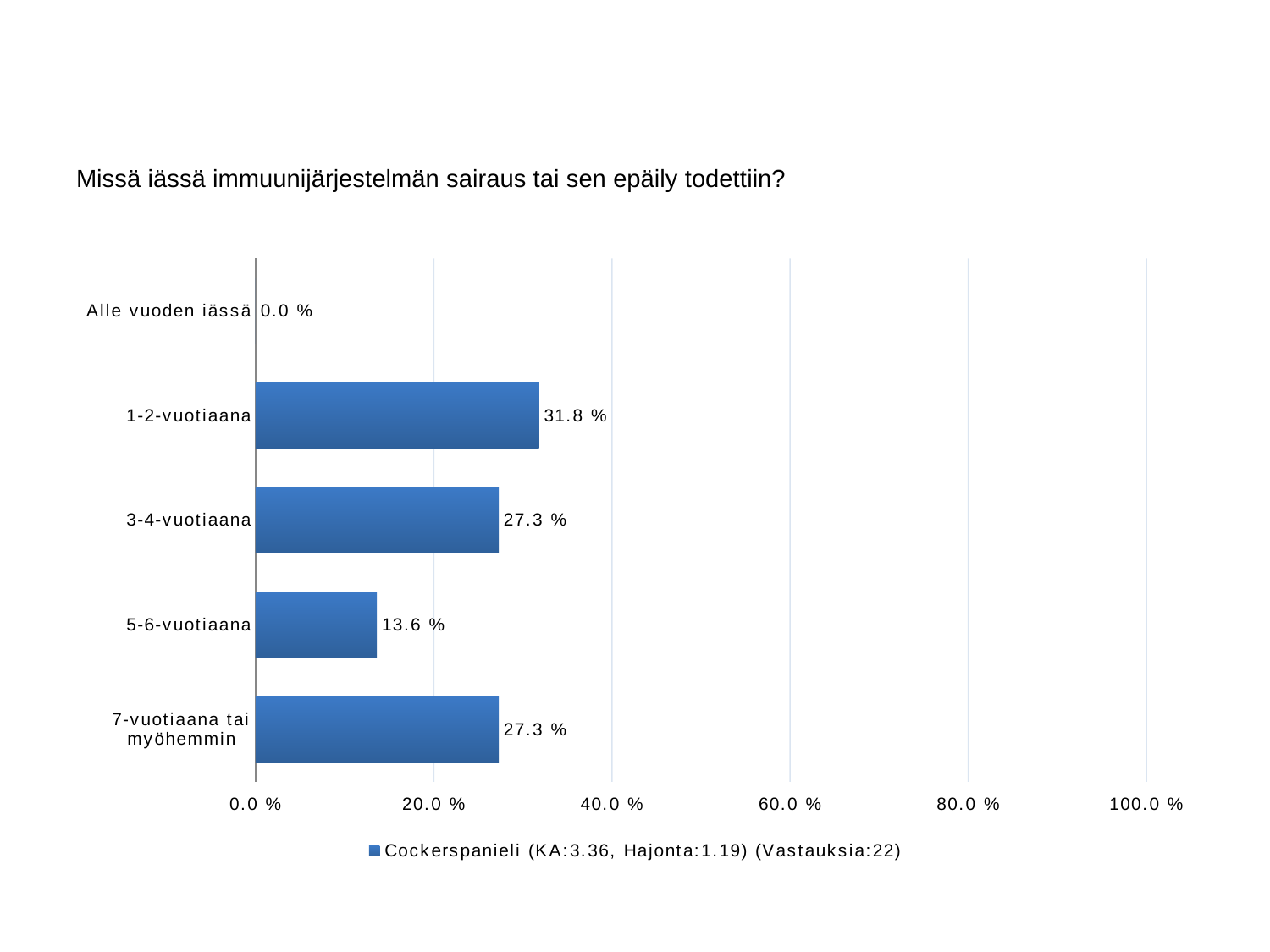
How many categories are shown on the chart? 5 Which category has the highest value? 1-2-vuotiaana What is the legend entry of the chart? Cockerspanieli (KA:3.36, Hajonta:1.19) (Vastauksia:22) What is the value for 1-2-vuotiaana? 31.8 % What is the difference between the values for 1-2-vuotiaana and 5-6-vuotiaana? 18.2 % Which is larger, the value for 3-4-vuotiaana or the value for 5-6-vuotiaana? 3-4-vuotiaana What is the value for 7-vuotiaana tai myöhemmin? 27.3 % Which category has the lowest value? Alle vuoden iässä What is the value for 5-6-vuotiaana? 13.6 % Is the value for 1-2-vuotiaana greater or less than 40.0 %? less What kind of chart is shown on the slide? bar chart What is the value for Alle vuoden iässä? 0.0 %